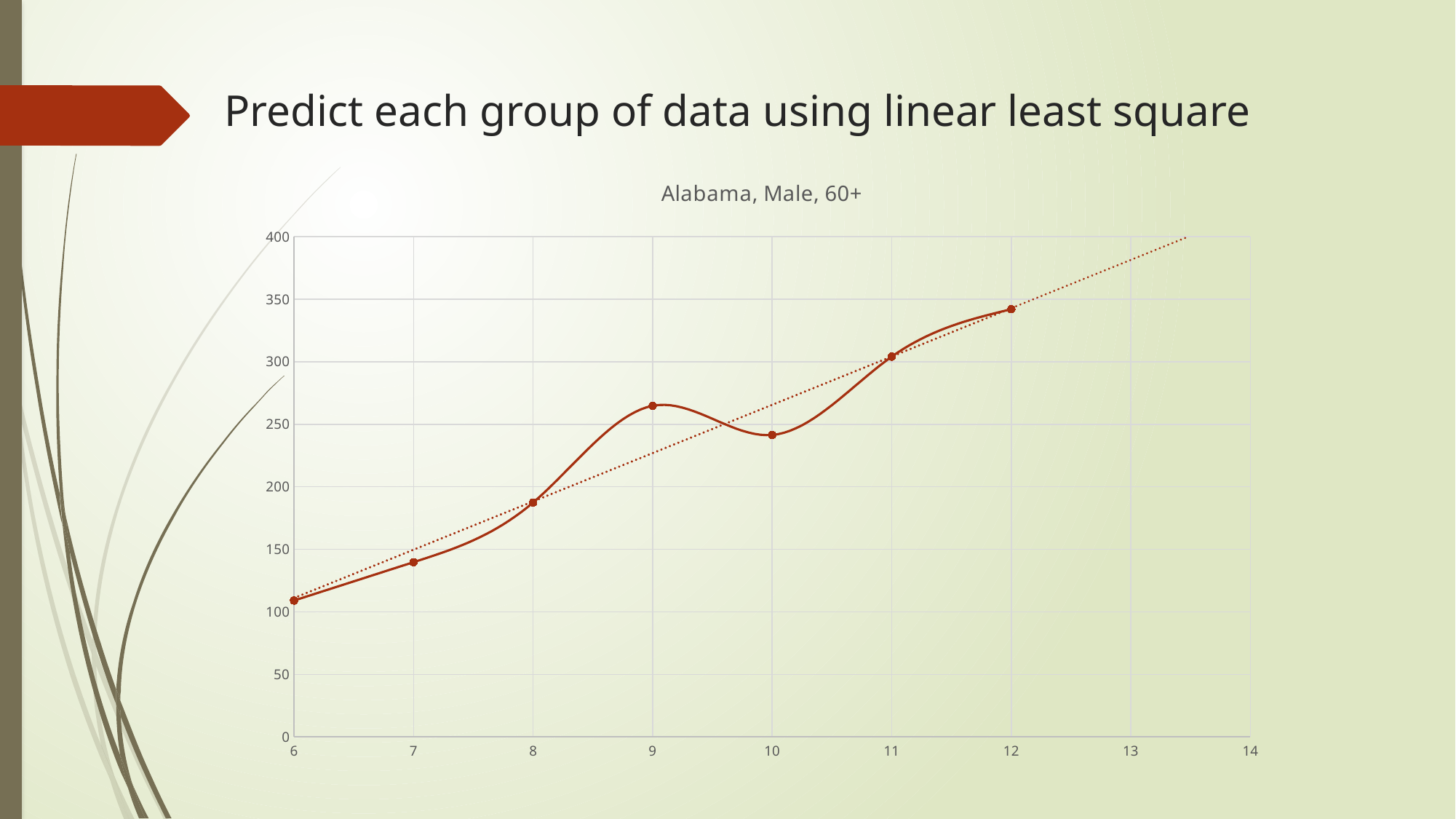
How many data points are plotted on the chart? 7 At which x value is the plotted value highest? 12 What is the title of the chart? Alabama, Male, 60+ At which x value is the plotted value lowest? 6 Which has the larger plotted value, x = 9 or x = 10? 9 Do the plotted values generally rise or fall as x increases from 6 to 12? rise Besides the solid data line, what other line is drawn on the chart? a dotted linear trendline Is the plotted value at x = 8 greater or less than 200? less What kind of chart is shown on the slide? line chart Is the plotted value at x = 12 greater or less than 350? less Is the plotted value at x = 6 greater or less than 100? greater